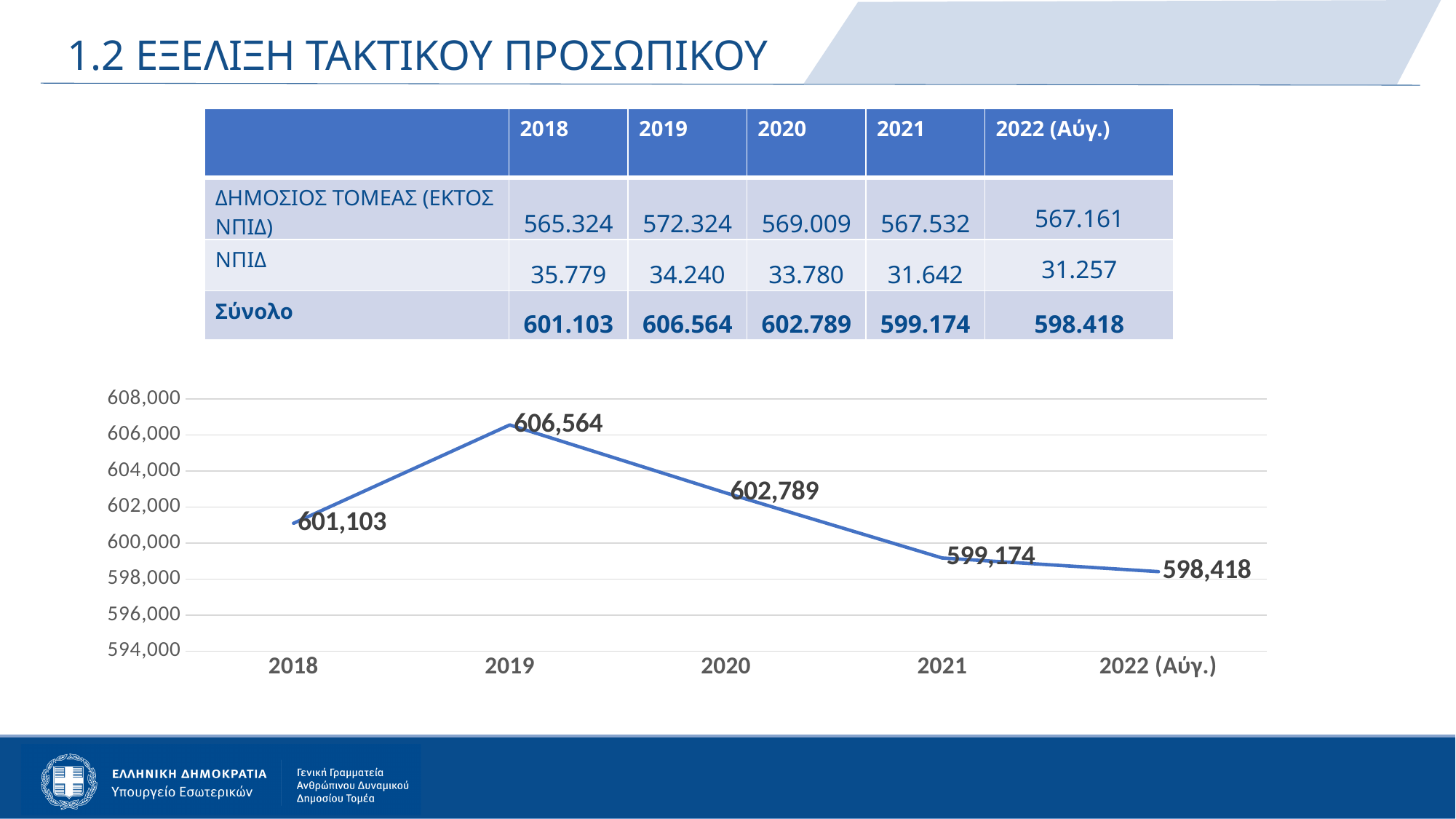
How many data points are plotted in the line chart? 5 What is the difference between the 2020 value and the 2021 value in the line chart? 3,615 What is the value plotted for 2022 (Αύγ.) in the line chart? 598,418 Is the value for 2021 in the line chart greater or less than 600,000? less What is the value plotted for 2019 in the line chart? 606,564 Which year has the lowest value in the line chart? 2022 (Αύγ.) Which year has the highest value in the line chart? 2019 Which is larger in the line chart, the value for 2020 or the value for 2021? 2020 What is the value plotted for 2018 in the line chart? 601,103 What is the difference between the 2019 value and the 2018 value in the line chart? 5,461 What type of chart is shown on the slide? line chart Does the line in the chart rise or fall from 2019 to 2022 (Αύγ.)? fall